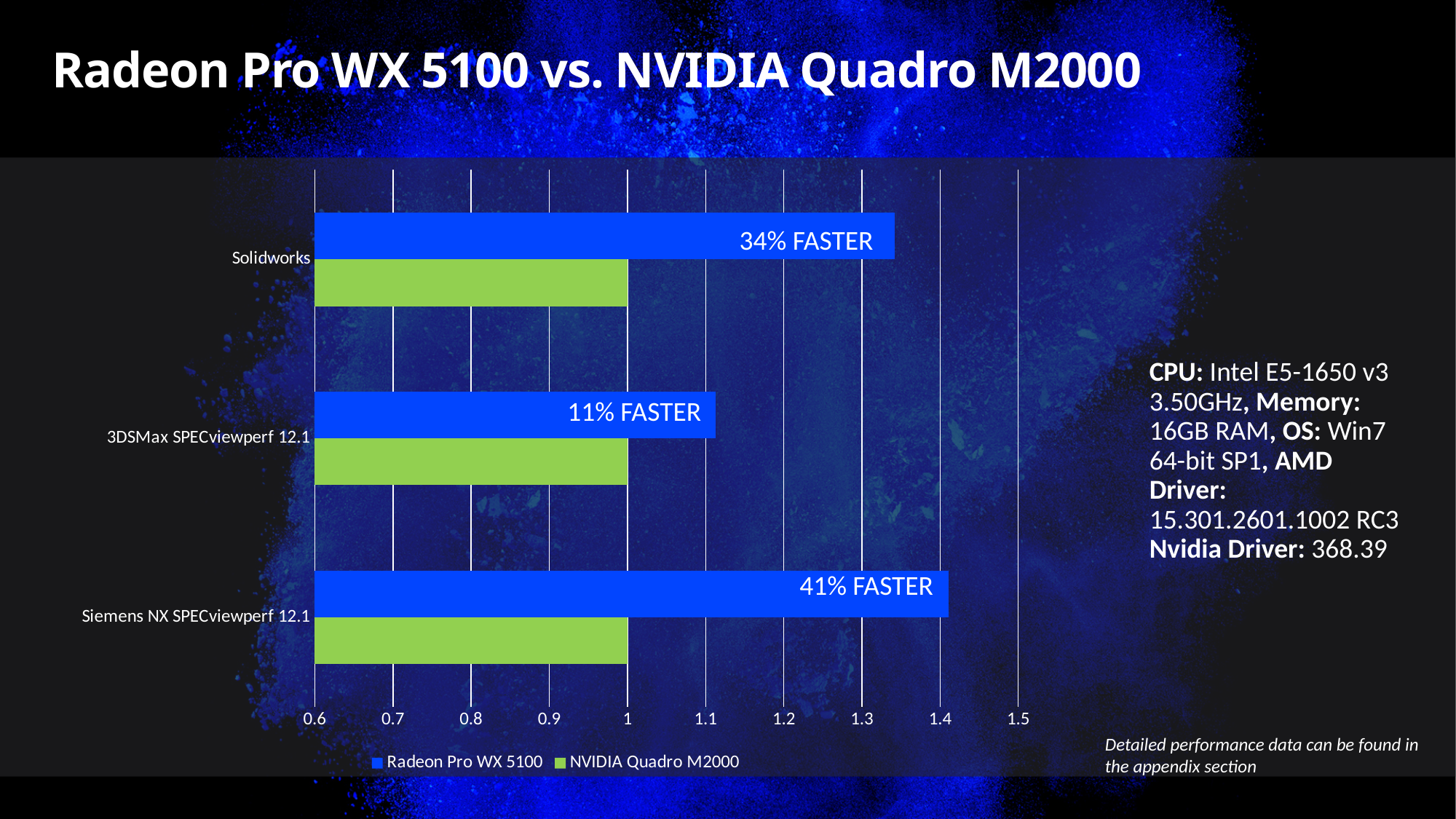
In the Solidworks category, which series has the larger value, Radeon Pro WX 5100 or NVIDIA Quadro M2000? Radeon Pro WX 5100 What is the value for NVIDIA Quadro M2000 in the Solidworks category? 1 Is the value for Radeon Pro WX 5100 in the Solidworks category greater or less than 1.3? greater What label is printed on the Radeon Pro WX 5100 bar for 3DSMax SPECviewperf 12.1? 11% FASTER In which category is the Radeon Pro WX 5100 bar the longest? Siemens NX SPECviewperf 12.1 What is the value for NVIDIA Quadro M2000 in the Siemens NX SPECviewperf 12.1 category? 1 What kind of chart is shown on the slide? bar chart What label is printed on the Radeon Pro WX 5100 bar for Siemens NX SPECviewperf 12.1? 41% FASTER How many categories (applications) are plotted on the chart? 3 How many series does the chart legend list? 2 In which category is the Radeon Pro WX 5100 bar the shortest? 3DSMax SPECviewperf 12.1 Is the value for Radeon Pro WX 5100 in the 3DSMax SPECviewperf 12.1 category greater or less than 1.2? less